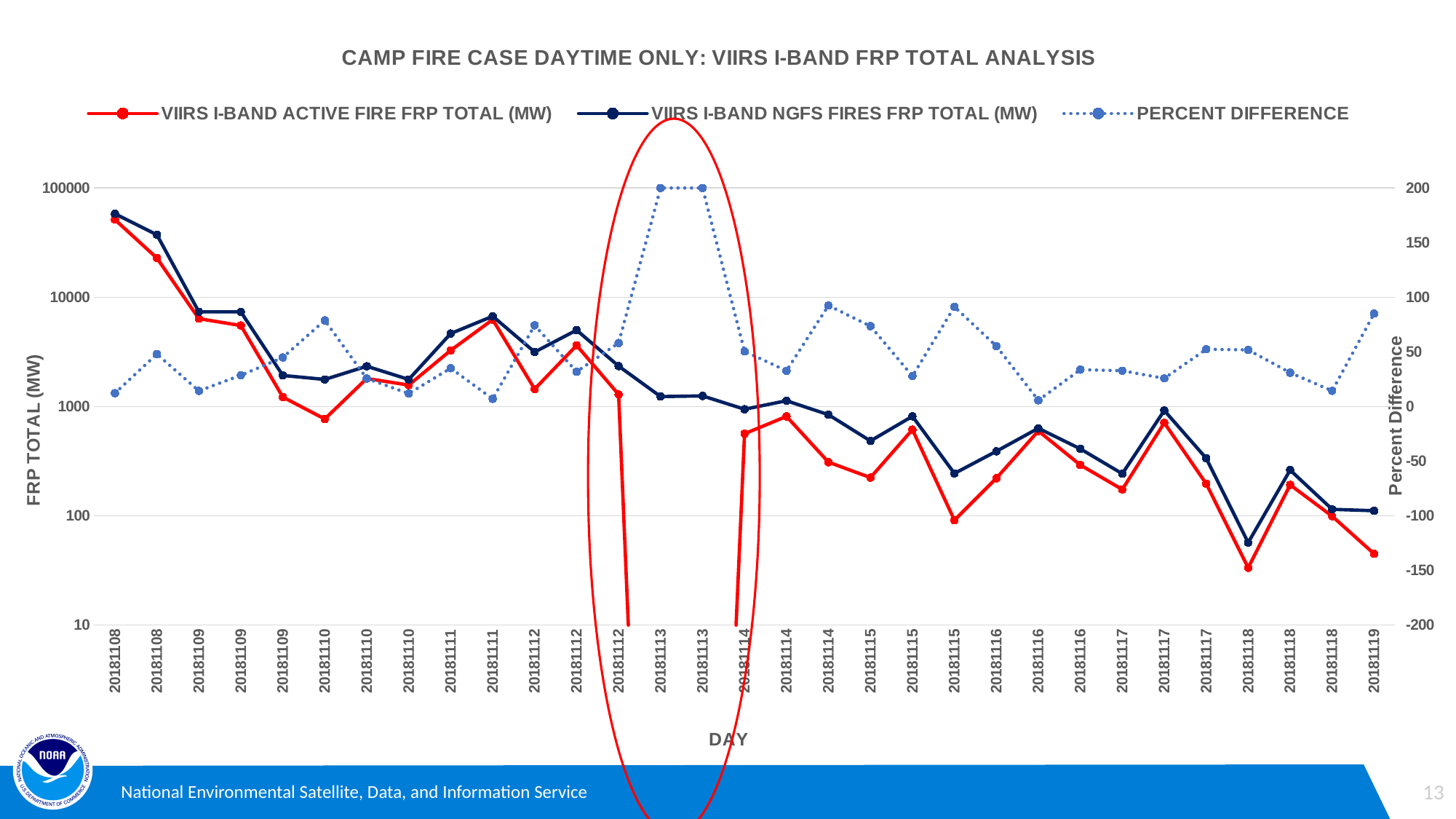
At the first 20181108 point, which series is higher: VIIRS I-BAND ACTIVE FIRE FRP TOTAL (MW) or VIIRS I-BAND NGFS FIRES FRP TOTAL (MW)? VIIRS I-BAND NGFS FIRES FRP TOTAL (MW) Overall, do the VIIRS I-BAND NGFS FIRES FRP TOTAL (MW) values rise or fall from 20181108 to 20181119? fall Is the value of VIIRS I-BAND ACTIVE FIRE FRP TOTAL (MW) at 20181119 greater or less than 100? less Is the PERCENT DIFFERENCE value at the first 20181113 point greater or less than 150? greater How many series does the legend list? 3 Is the value of VIIRS I-BAND ACTIVE FIRE FRP TOTAL (MW) at the first 20181108 point greater or less than 10000? greater What is the label of the left vertical axis? FRP TOTAL (MW) What is the title of the chart? CAMP FIRE CASE DAYTIME ONLY: VIIRS I-BAND FRP TOTAL ANALYSIS At which day does the PERCENT DIFFERENCE series reach its highest value? 20181113 How many data points are plotted along the x axis for each series? 31 What kind of chart is shown on the slide? line chart